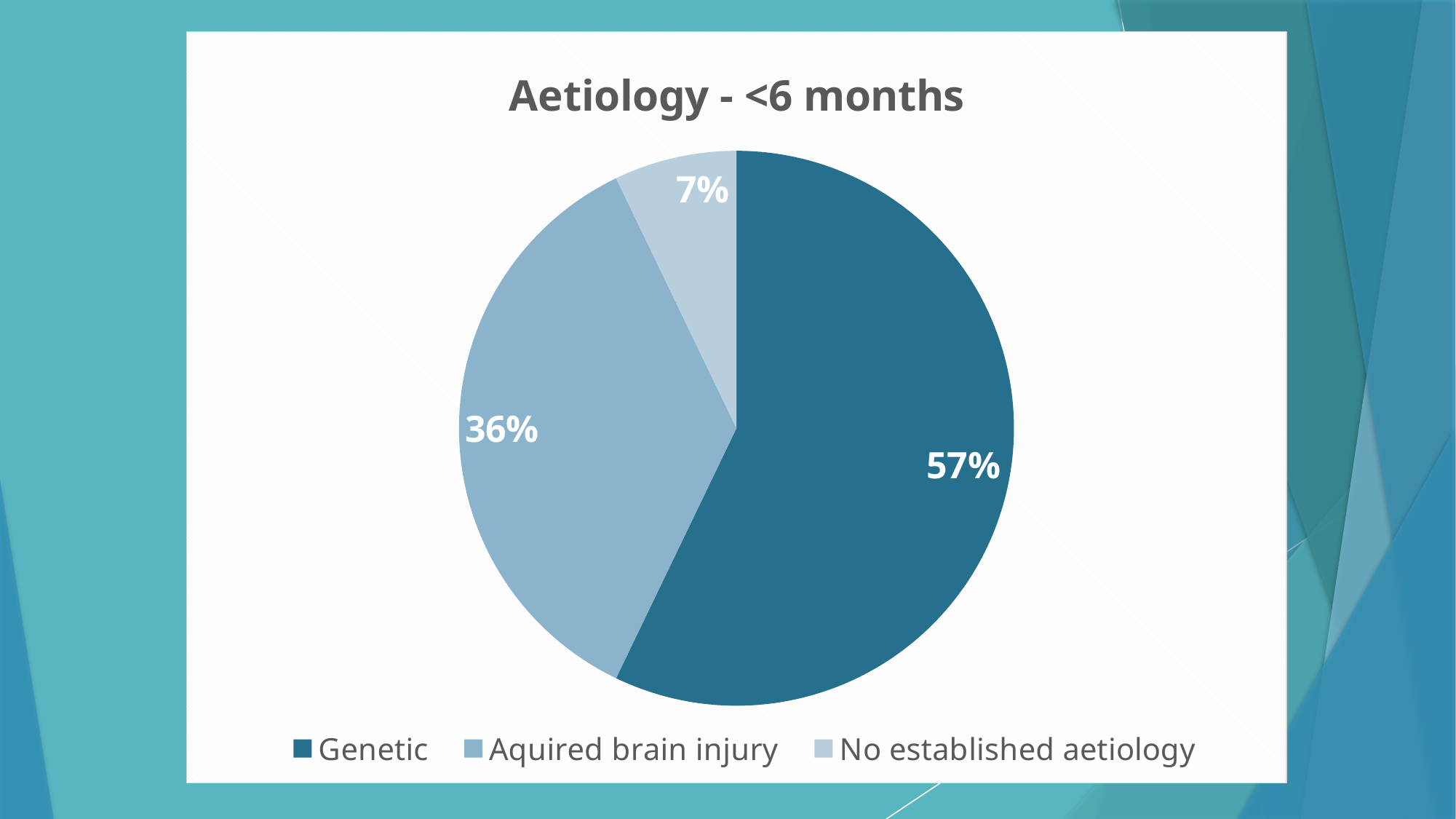
What percentage of the pie is Genetic? 57% What percentage of the pie is Aquired brain injury? 36% Which category has the largest share of the pie? Genetic What percentage of the pie is No established aetiology? 7% Which is larger, the share for Genetic or the share for Aquired brain injury? Genetic What is the difference in percentage points between Aquired brain injury and No established aetiology? 29 What is the difference in percentage points between Genetic and Aquired brain injury? 21 What is the title of the chart? Aetiology - <6 months How many categories are shown in the pie chart? 3 Which legend entry is shown with the darkest colour? Genetic Which category has the smallest share of the pie? No established aetiology What kind of chart is shown on the slide? Pie chart